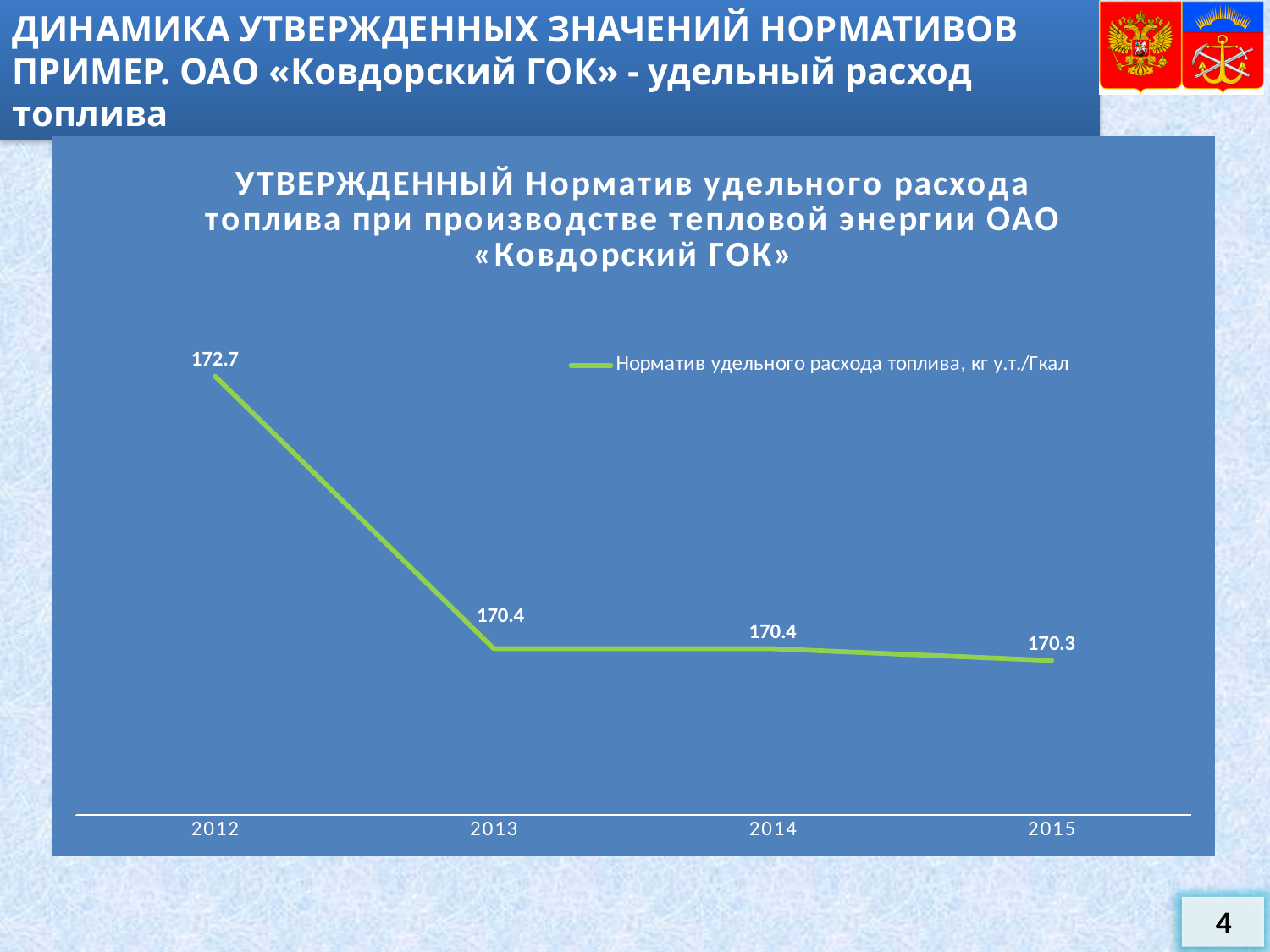
What is the value for 2012? 172.7 Which year has the lowest value? 2015 What is the difference between the values for 2014 and 2015? 0.1 What is the value for 2015? 170.3 Do the values rise or fall from 2012 to 2015? fall How many series does the legend list? 1 What kind of chart is shown? line chart How many years are plotted on the x axis? 4 What is the difference between the values for 2012 and 2013? 2.3 Which year has the highest value? 2012 Which is larger, the value for 2012 or the value for 2014? 2012 What is the value for 2013? 170.4